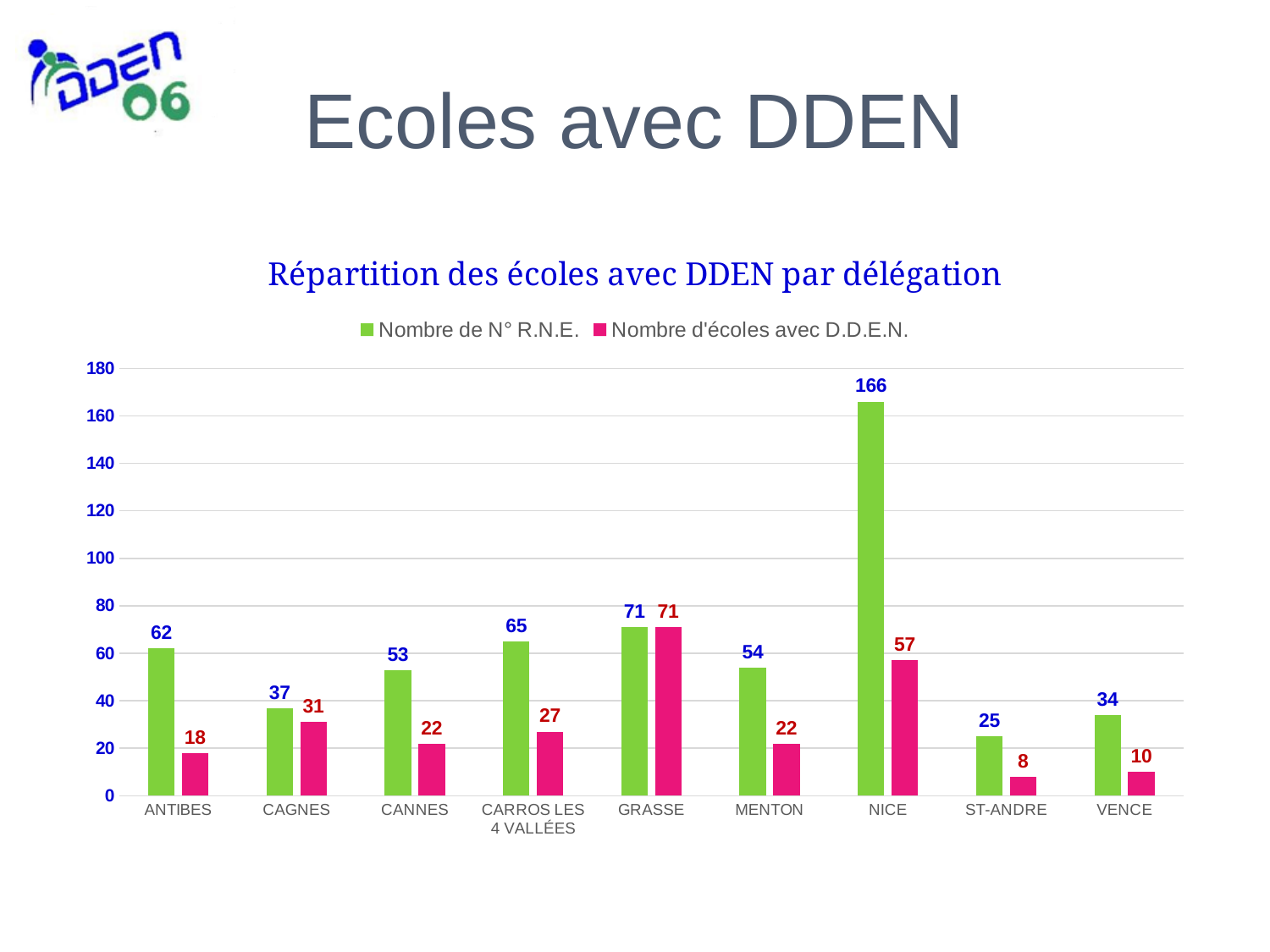
Which delegation has the highest Nombre de N° R.N.E.? NICE Which delegation has the lowest Nombre d'écoles avec D.D.E.N.? ST-ANDRE What is the value of Nombre d'écoles avec D.D.E.N. for ST-ANDRE? 8 What is the value of Nombre d'écoles avec D.D.E.N. for CAGNES? 31 What kind of chart is shown on the slide? bar chart How many delegations are shown on the x axis? 9 Which is larger: Nombre d'écoles avec D.D.E.N. for GRASSE or for NICE? GRASSE What is the difference between Nombre de N° R.N.E. and Nombre d'écoles avec D.D.E.N. for ANTIBES? 44 How many series does the legend list? 2 Is the value of Nombre de N° R.N.E. for NICE greater or less than 140? greater What is the value of Nombre de N° R.N.E. for NICE? 166 What is the title of the chart? Répartition des écoles avec DDEN par délégation